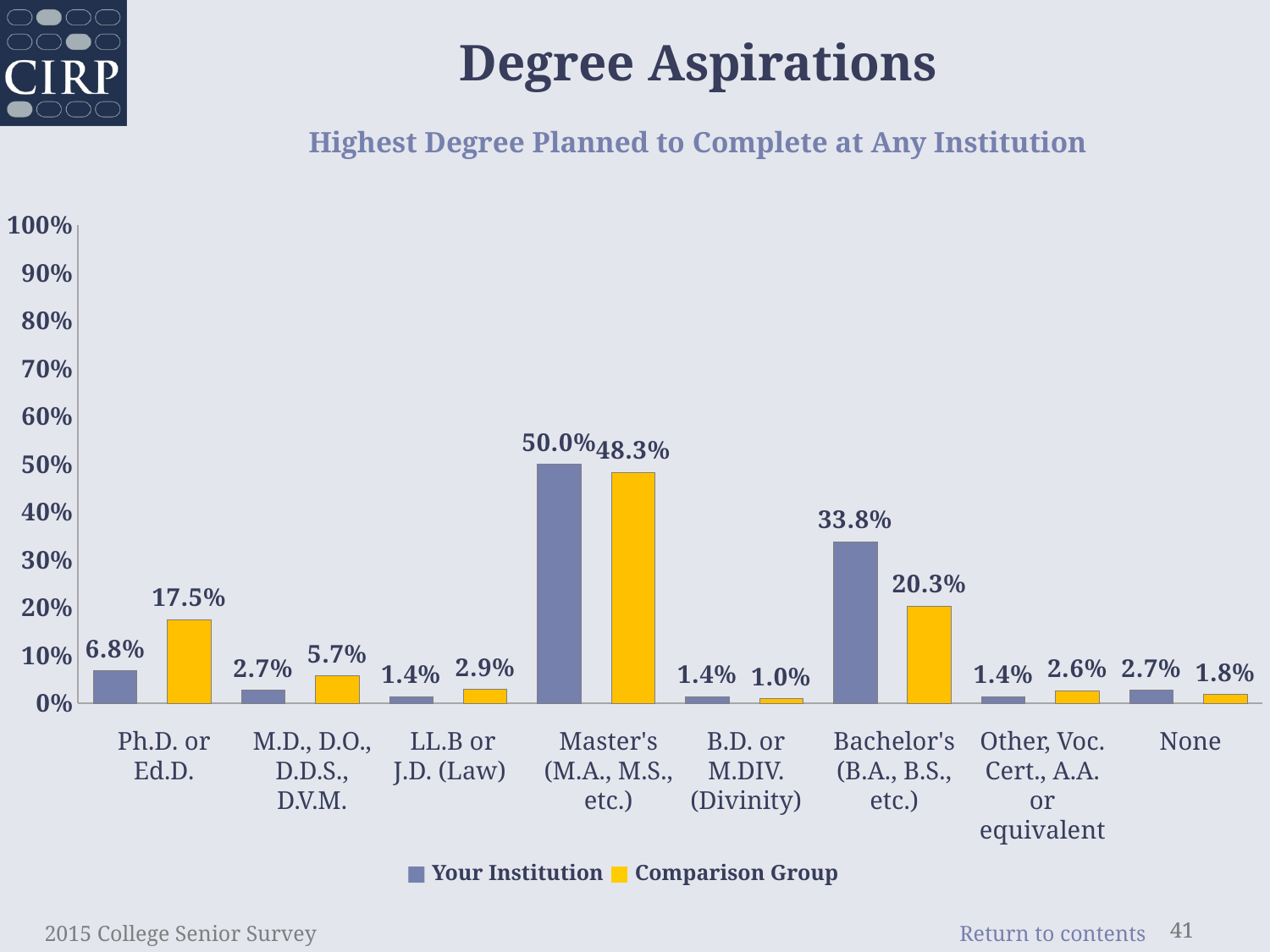
How many categories are shown on the x axis? 8 Which is larger for M.D., D.O., D.D.S., D.V.M.: Your Institution or Comparison Group? Comparison Group Which category has the lowest value for Comparison Group? B.D. or M.DIV. (Divinity) What is the value for Your Institution for Master's (M.A., M.S., etc.)? 50.0% What is the subtitle of the chart? Highest Degree Planned to Complete at Any Institution What is the difference between Comparison Group and Your Institution for Ph.D. or Ed.D.? 10.7% Which category has the highest value for Comparison Group? Master's (M.A., M.S., etc.) What is the difference between Your Institution and Comparison Group for Bachelor's (B.A., B.S., etc.)? 13.5% What is the value for Comparison Group for Ph.D. or Ed.D.? 17.5% What is the value for Your Institution for Bachelor's (B.A., B.S., etc.)? 33.8% How many series does the legend list? 2 What kind of chart is shown on the slide? bar chart